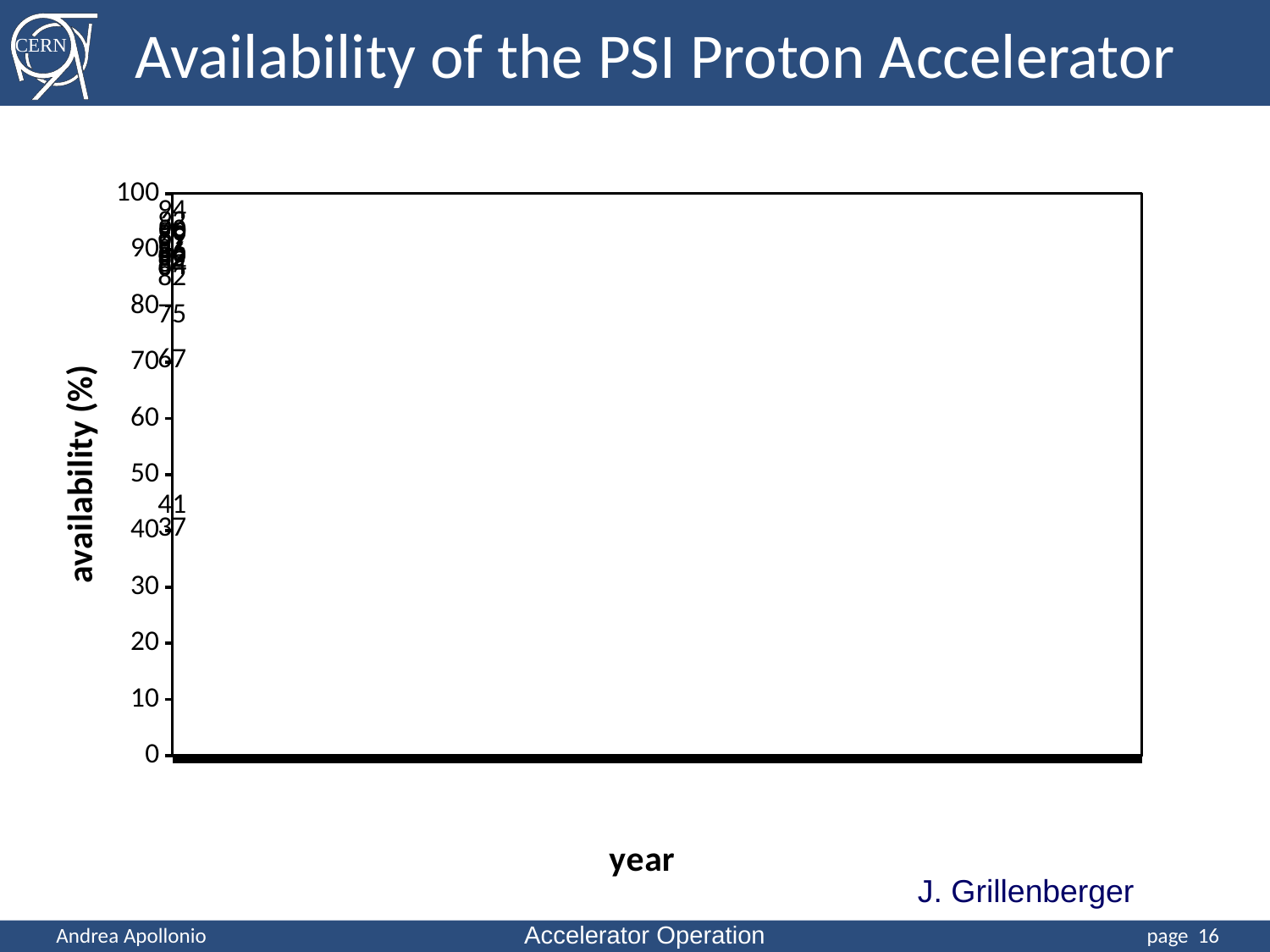
What is the label on the horizontal axis of the chart? year What is the lowest availability value printed as a data label on the chart? 37 What is the label on the vertical axis of the chart? availability (%) What is the highest availability value printed as a data label on the chart? 94